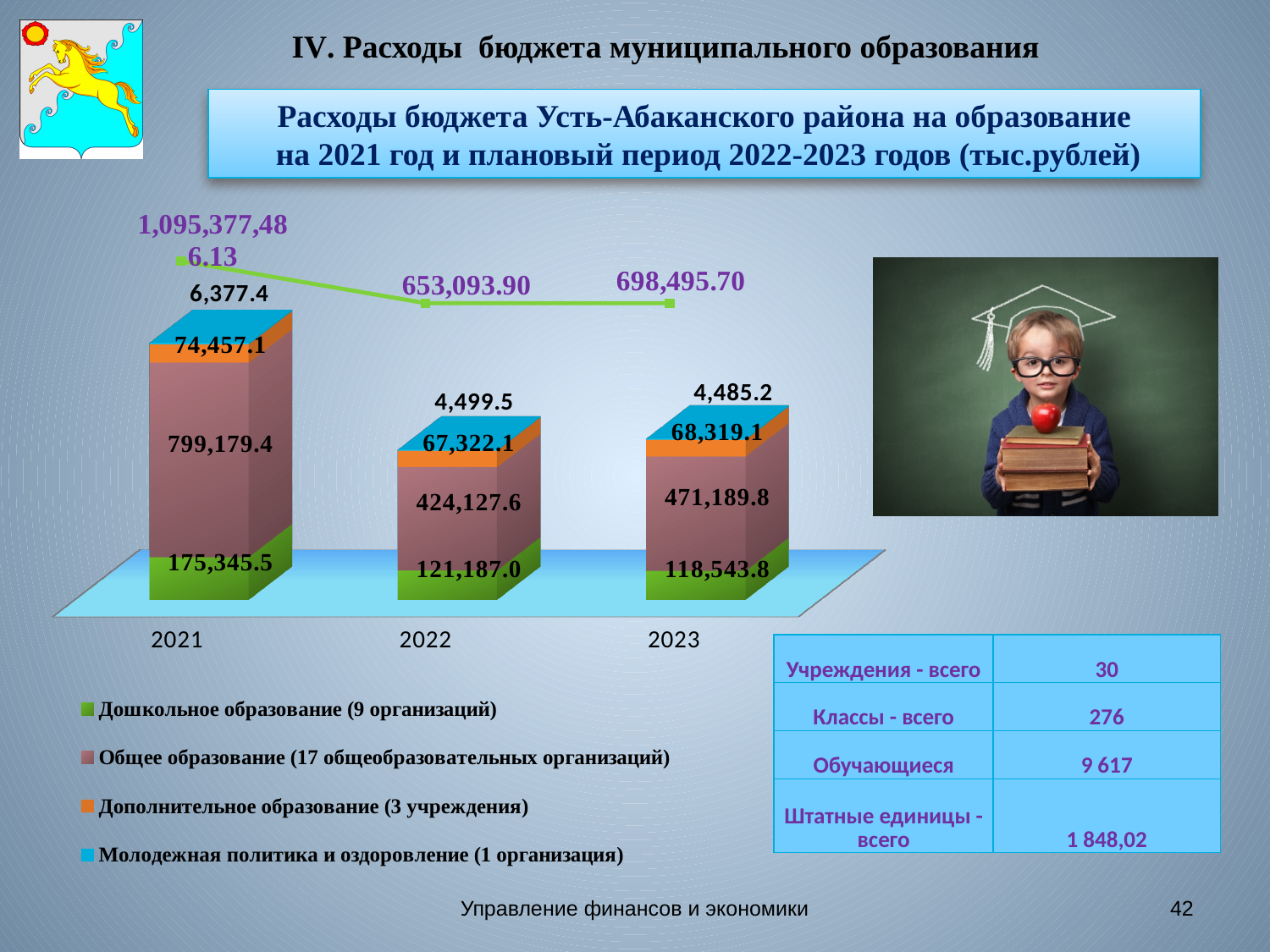
What kind of chart is used to show the education expenditures? Stacked bar chart What is the difference between the Общее образование values for 2023 and 2022? 47,062.2 In which year is the value for Дошкольное образование the lowest? 2023 What is the value for Молодежная политика и оздоровление in 2023? 4,485.2 What is the value for Дошкольное образование in 2022? 121,187.0 Which is larger, the Дополнительное образование value for 2022 or for 2023? 2023 In which year is the value for Общее образование the highest? 2021 How many series does the legend list? 4 How many years are shown on the x axis of the chart? 3 What is the value for Общее образование in 2021? 799,179.4 What is the value for Дополнительное образование in 2021? 74,457.1 What value is printed on the line marker above the 2022 bar? 653,093.90